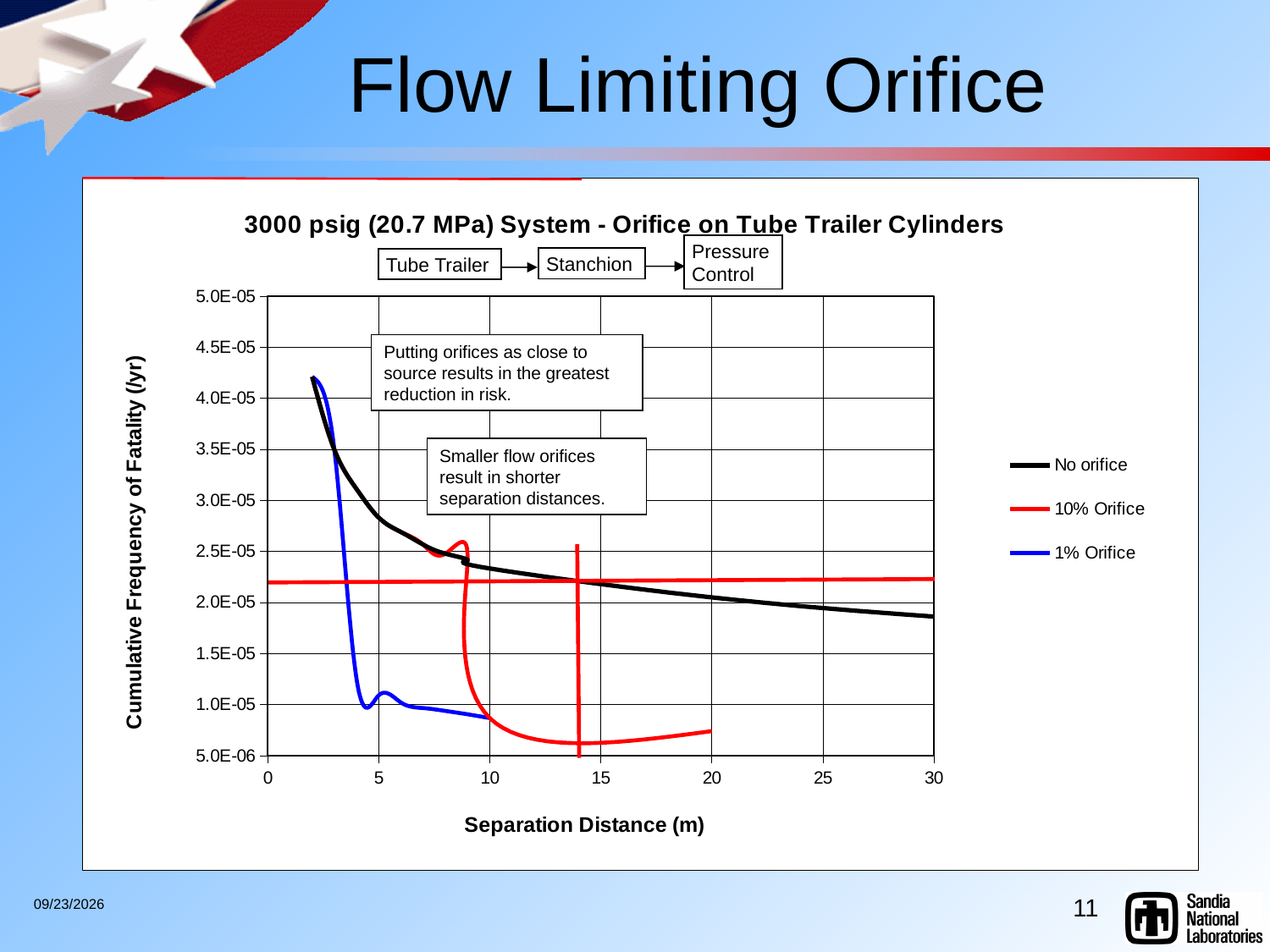
What is the title of the chart? 3000 psig (20.7 MPa) System - Orifice on Tube Trailer Cylinders How many series does the chart's legend list? 3 What kind of chart is shown on the slide? line chart Is the value of the No orifice curve at a separation distance of 5 m greater or less than 2.5E-05? greater At a separation distance of 10 m, which curve has the higher value: No orifice or 1% Orifice? No orifice Which series reaches the lowest cumulative frequency of fatality on the chart? 10% Orifice Is the value of the No orifice curve at a separation distance of 30 m greater or less than 2.0E-05? less Is the value of the 1% Orifice curve at a separation distance of 5 m greater or less than 1.5E-05? less What is the label of the x axis of the chart? Separation Distance (m) Does the No orifice curve rise or fall as separation distance increases? fall